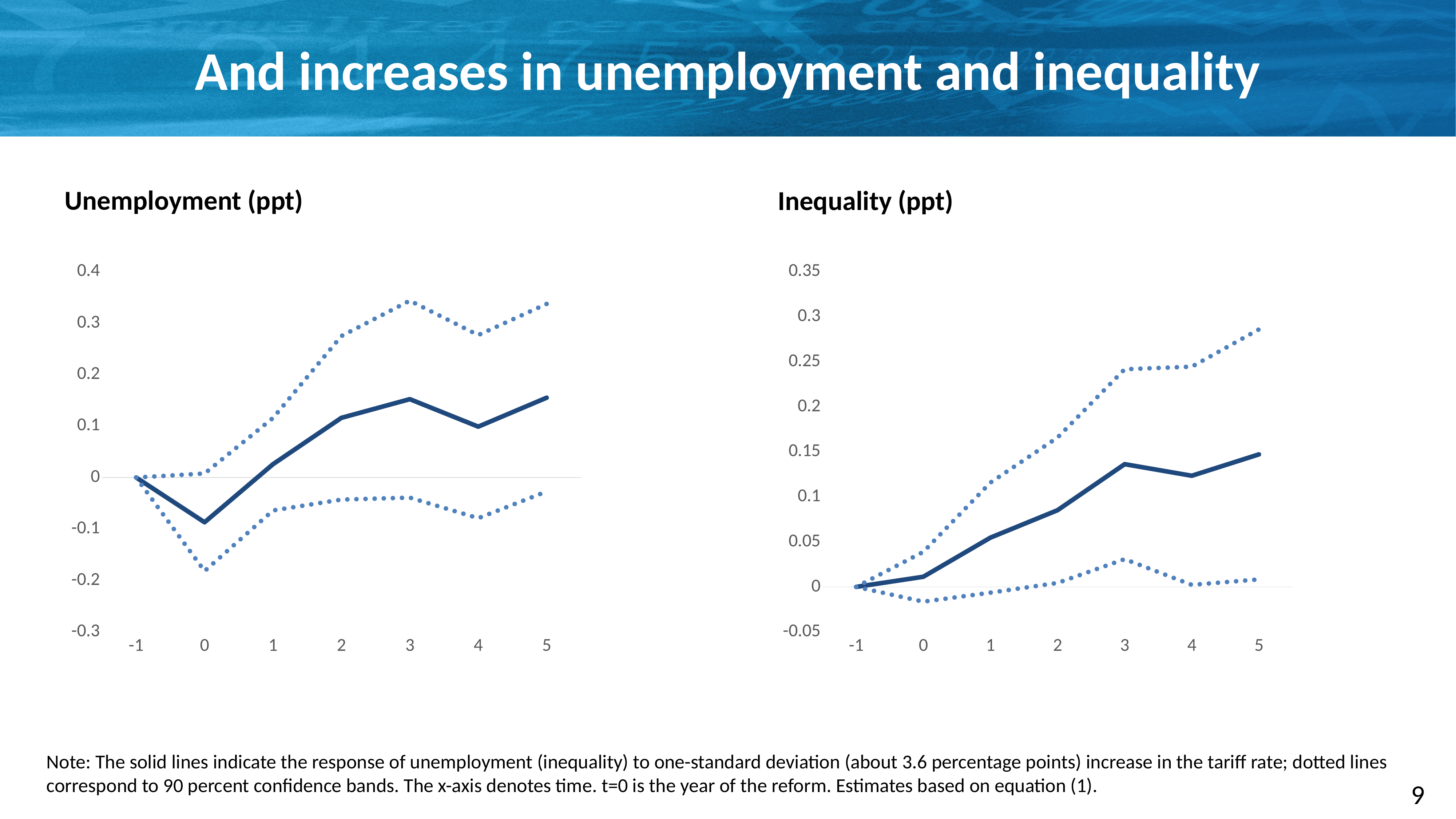
How many time points are shown on the x axis of the Inequality (ppt) chart? 7 In the Inequality (ppt) chart, does the solid line generally rise or fall from t = -1 to t = 5? rise In the Inequality (ppt) chart, is the solid line value at t = 5 greater or less than 0.1? greater What kind of chart is the Unemployment (ppt) chart? line chart In the Unemployment (ppt) chart, is the solid line value at t = 3 greater or less than 0.1? greater In the Inequality (ppt) chart, is the solid line value at t = 3 larger or smaller than at t = 1? larger In the Inequality (ppt) chart, is the upper dotted line at t = 5 greater or less than 0.25? greater In the Unemployment (ppt) chart, at which time point is the solid line lowest? 0 In the Unemployment (ppt) chart, what is the value of the solid line at t = -1? 0 In the Inequality (ppt) chart, what is the value of the solid line at t = -1? 0